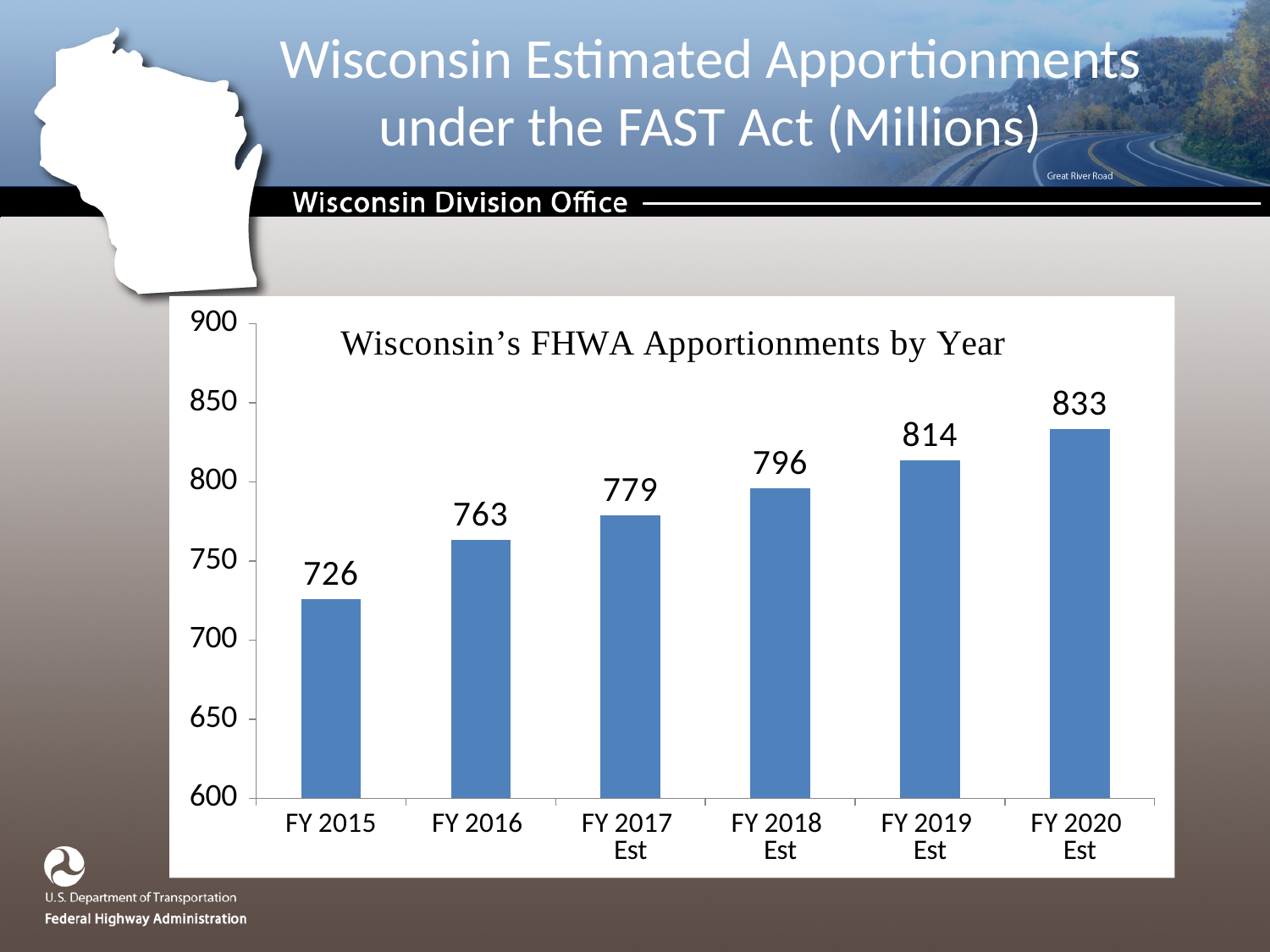
What kind of chart is shown on the slide? bar chart Is the value for FY 2018 Est greater or less than 800? less What is the difference between the FY 2020 Est and FY 2015 values? 107 How many fiscal years are shown on the chart? 6 What is the value for FY 2020 Est? 833 What is the value for FY 2015? 726 Which fiscal year has the highest apportionment? FY 2020 Est Do the values rise or fall from FY 2015 to FY 2020 Est? rise What is the difference between the FY 2017 Est and FY 2016 values? 16 Which is larger, the value for FY 2019 Est or FY 2016? FY 2019 Est What is the value for FY 2018 Est? 796 Which fiscal year has the lowest apportionment? FY 2015